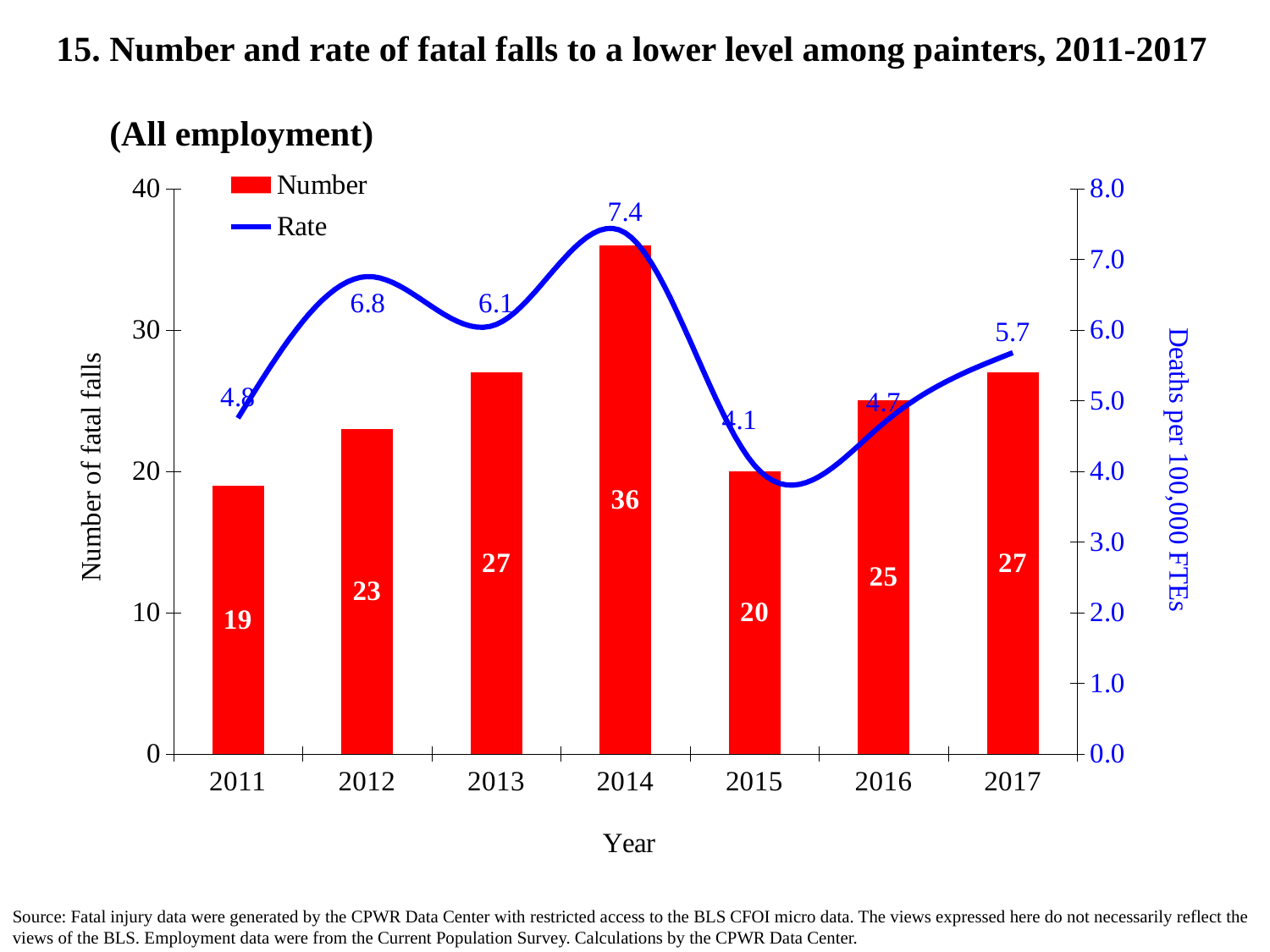
What was the number of fatal falls in 2016? 25 What was the rate of fatal falls (deaths per 100,000 FTEs) in 2012? 6.8 What is the label of the right-hand vertical axis? Deaths per 100,000 FTEs Which year had the highest number of fatal falls? 2014 Which year had a higher rate of fatal falls, 2013 or 2017? 2013 How many years are shown on the x axis? 7 What was the number of fatal falls among painters in 2014? 36 What kind of chart is used to show the Number series? Bar chart How many series does the legend list? 2 Which year had the lowest rate of fatal falls? 2015 What is the difference between the number of fatal falls in 2014 and in 2015? 16 Which year had the lowest number of fatal falls? 2011